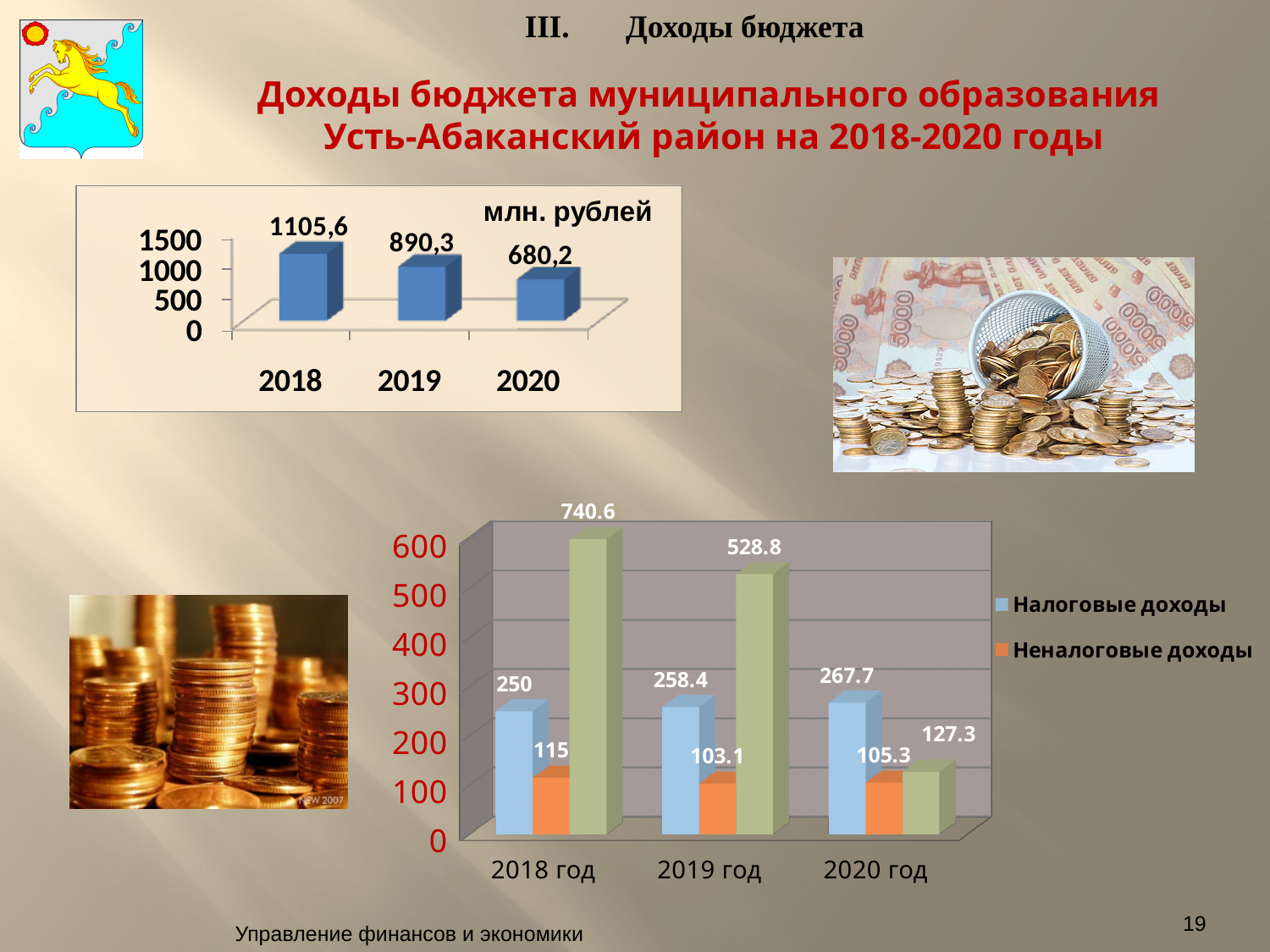
What type of chart is the bottom chart? bar chart In the bottom chart, which year has the highest value of Налоговые доходы? 2020 год In the top chart, what is the difference between the 2018 and 2019 values? 215,3 In the bottom chart, which is larger: Неналоговые доходы for 2019 год or for 2020 год? 2020 год In the top chart, what is the value for 2020? 680,2 In the bottom chart, how many series does the legend list? 2 In the top chart, do the values rise or fall from 2018 to 2020? fall In the top chart, what is the value for 2018? 1105,6 In the bottom chart, what is the value of Неналоговые доходы for 2018 год? 115 In the top chart, which year has the lowest value? 2020 In the top chart, what unit is shown for the values? млн. рублей In the bottom chart, what is the value of Налоговые доходы for 2019 год? 258.4